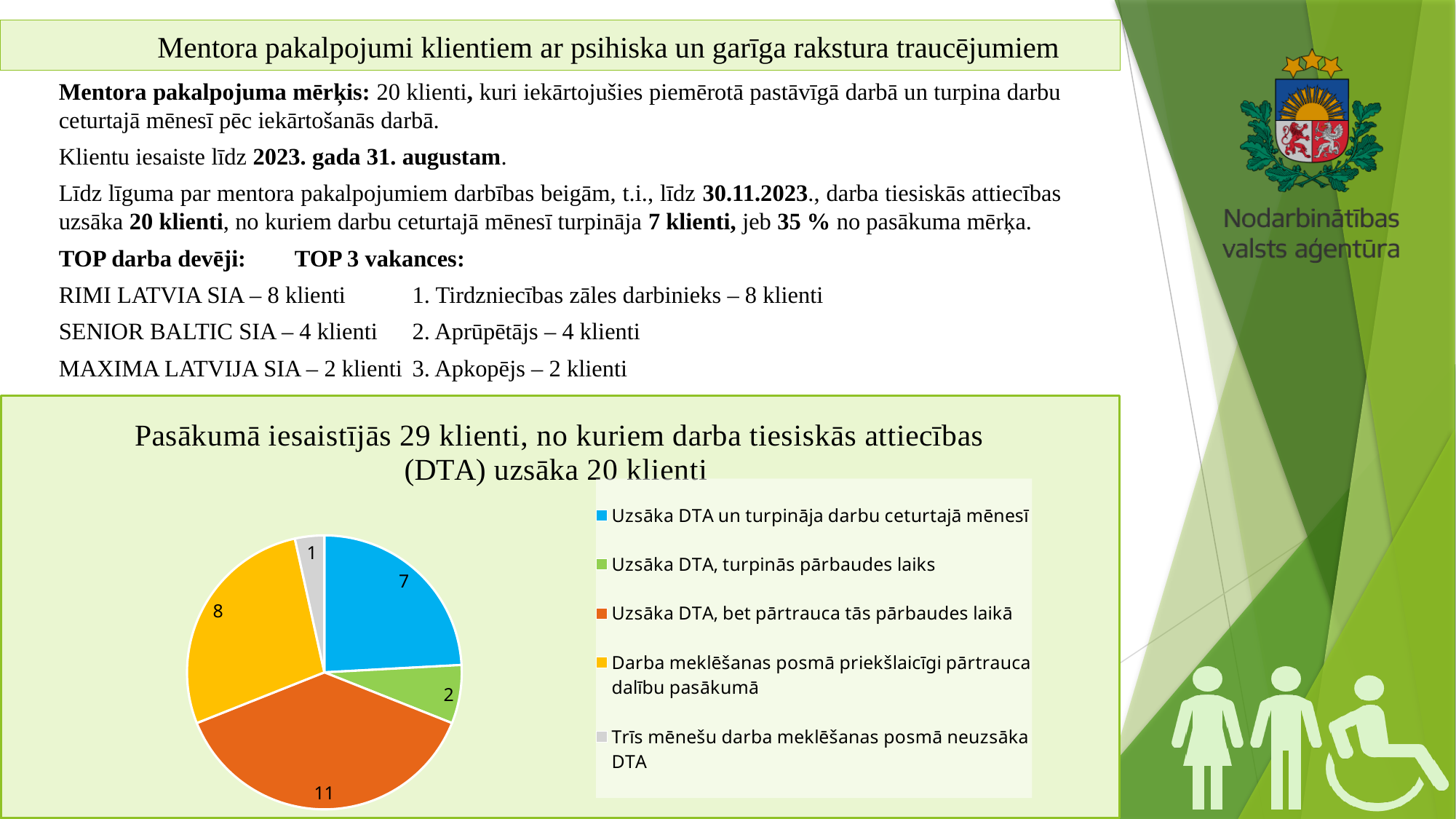
Which is larger in the pie chart: "Uzsāka DTA un turpināja darbu ceturtajā mēnesī" or "Darba meklēšanas posmā priekšlaicīgi pārtrauca dalību pasākumā"? Darba meklēšanas posmā priekšlaicīgi pārtrauca dalību pasākumā What is the difference between the values for "Uzsāka DTA, bet pārtrauca tās pārbaudes laikā" and "Darba meklēšanas posmā priekšlaicīgi pārtrauca dalību pasākumā"? 3 How many entries does the pie chart's legend list? 5 What kind of chart is shown on the slide? pie chart Which category has the smallest slice in the pie chart? Trīs mēnešu darba meklēšanas posmā neuzsāka DTA What is the value for "Trīs mēnešu darba meklēšanas posmā neuzsāka DTA" in the pie chart? 1 How many slices does the pie chart have? 5 What is the value for "Uzsāka DTA, turpinās pārbaudes laiks" in the pie chart? 2 What is the value for "Uzsāka DTA un turpināja darbu ceturtajā mēnesī" in the pie chart? 7 Which category has the largest slice in the pie chart? Uzsāka DTA, bet pārtrauca tās pārbaudes laikā What colour is the slice for "Darba meklēšanas posmā priekšlaicīgi pārtrauca dalību pasākumā" in the pie chart? yellow What is the value for "Uzsāka DTA, bet pārtrauca tās pārbaudes laikā" in the pie chart? 11